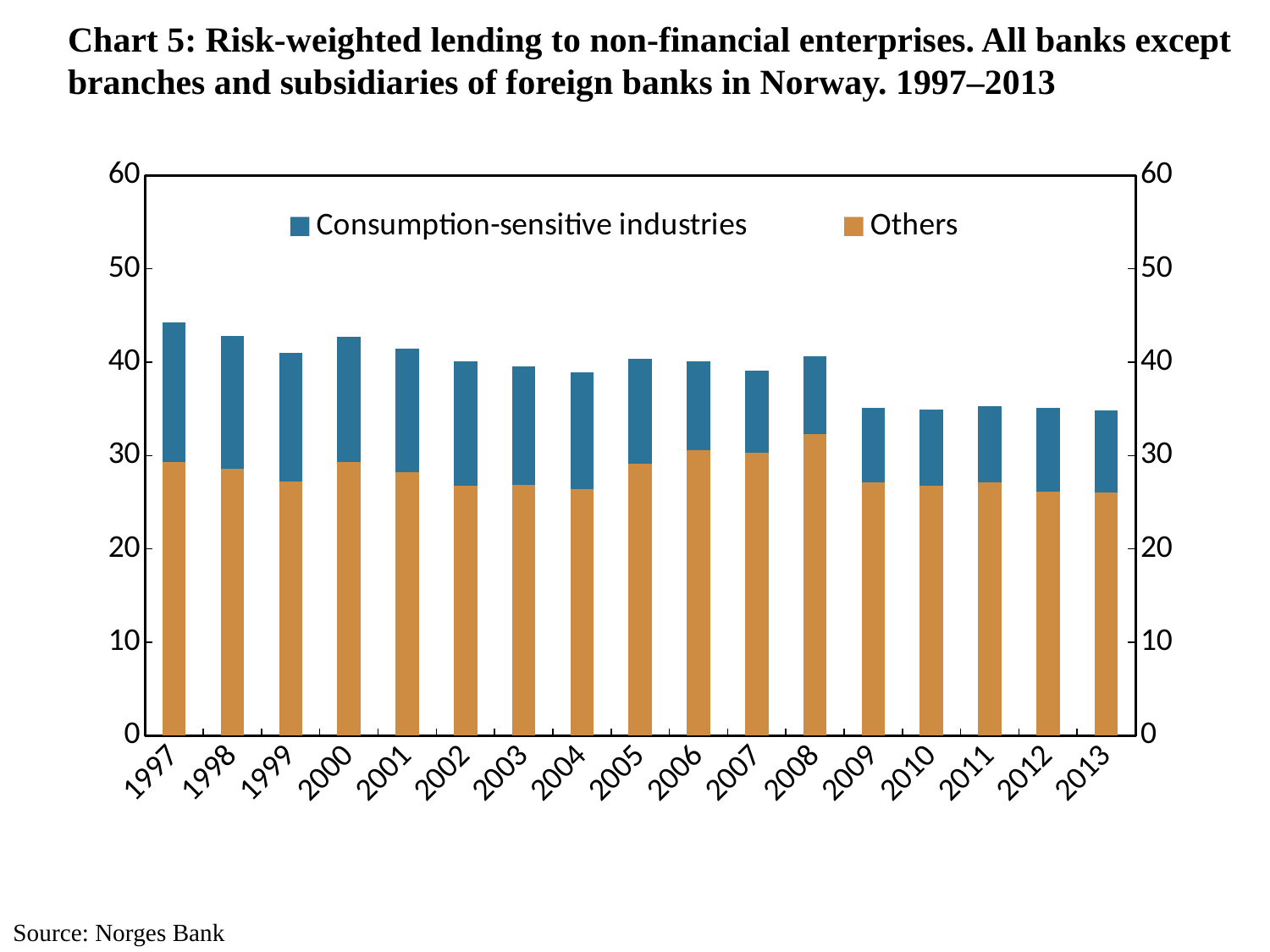
How many series does the legend list? 2 Which year has the highest total bar? 1997 What kind of chart is shown on the slide? Stacked bar chart How many years are shown on the x axis? 17 Which year has the highest value for Others? 2008 Is the total bar for 1997 greater or less than 40? greater Is the value for Others in 2004 greater or less than 30? less Do the total bars generally rise or fall from 1997 to 2013? fall What is the source given for the chart? Norges Bank Which is larger, the total bar for 1997 or the total bar for 2009? 1997 Is the total bar for 2013 greater or less than 40? less